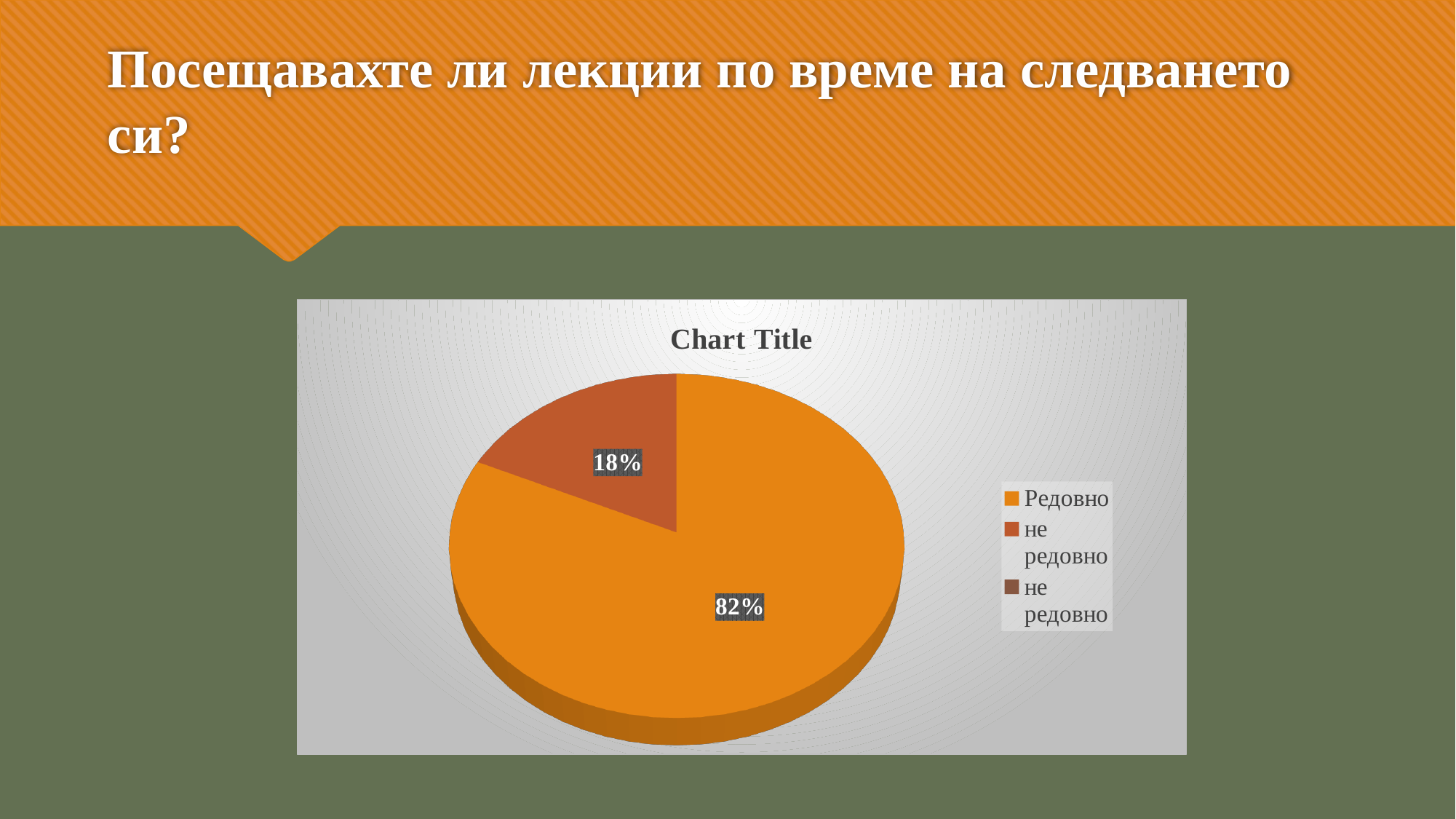
Which is larger, the "Редовно" slice or the "не редовно" slice? Редовно What kind of chart is shown on the slide? pie chart What is the difference in percentage points between the "Редовно" slice and the "не редовно" slice? 64 What is the total of the two labelled slices in the pie chart? 100% What colour is the "Редовно" slice of the pie? orange Which slice of the pie is the largest? Редовно Which slice of the pie is the smallest? не редовно What share of the pie does the "Редовно" slice represent? 82% How many entries does the chart legend list? 3 How many slices are visible in the pie chart? 2 What is the title printed above the pie chart? Chart Title What percentage is shown on the "не редовно" slice of the pie? 18%